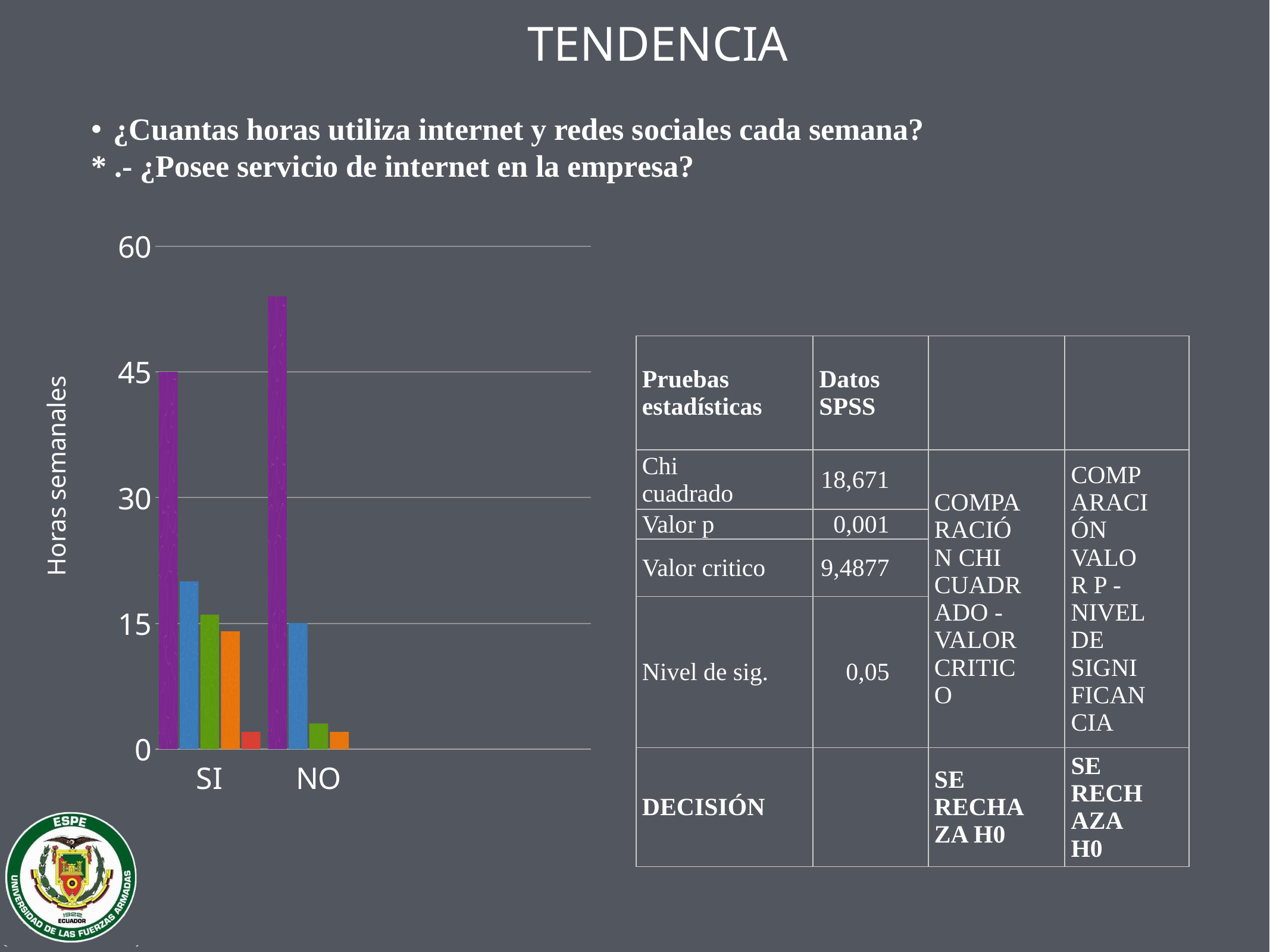
Is the value of the purple bar for NO greater or less than 45? greater What is the title of the vertical axis of the chart? Horas semanales What is the value of the blue bar for NO? 15 Is the value of the blue bar for SI greater or less than 15? greater How many categories are shown on the x axis of the chart? 2 What kind of chart is shown on the slide? bar chart What are the two categories on the x axis of the chart? SI and NO Is the value of the purple bar for NO greater or less than 60? less What is the value of the purple bar for SI? 45 Which category has the taller blue bar, SI or NO? SI Which category has the taller purple bar, SI or NO? NO